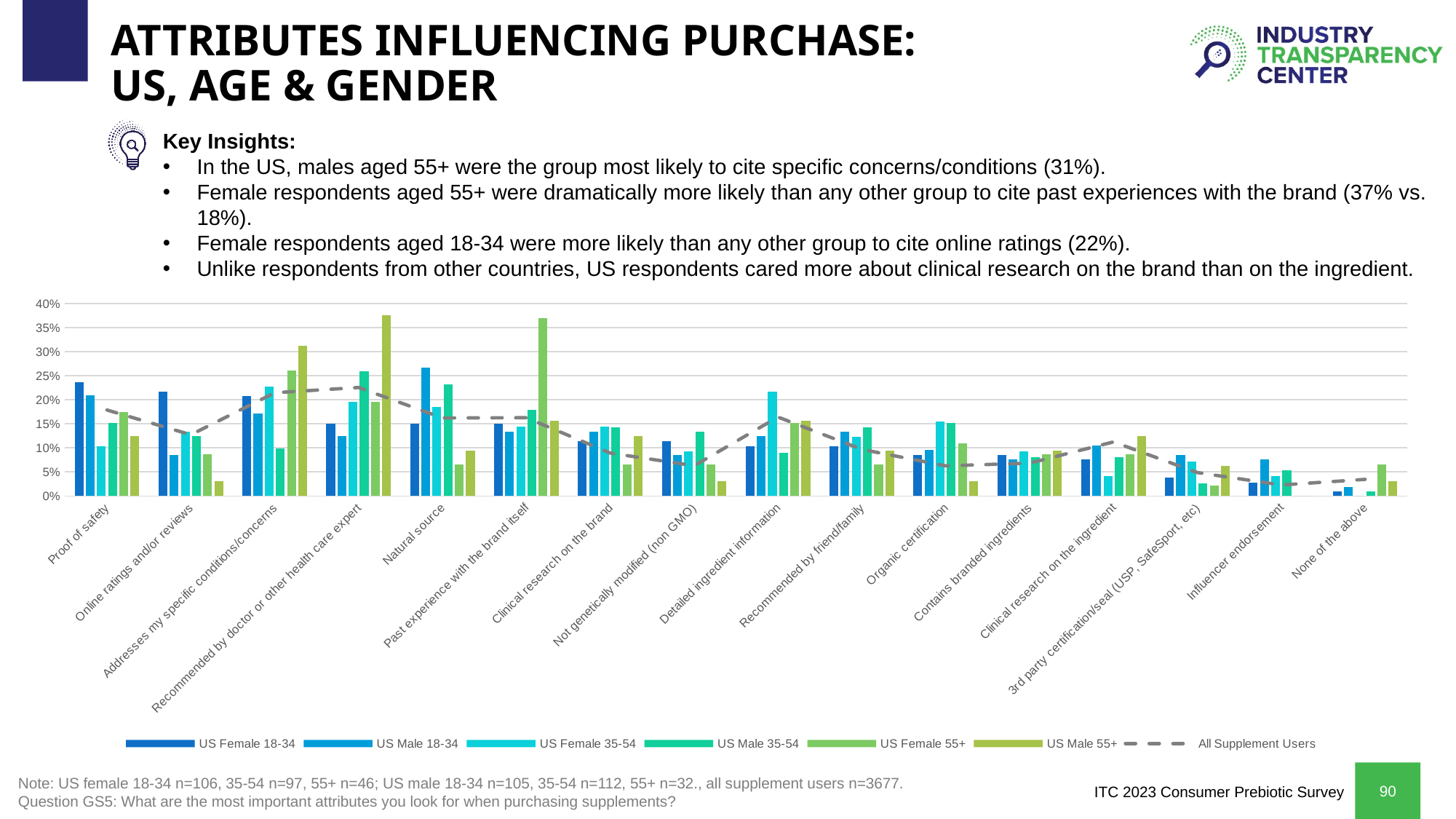
Which series is shown in dark blue in the chart legend? US Female 18-34 How many attribute categories are shown along the x axis of the chart? 16 Is the value for US Female 55+ on 'Past experience with the brand itself' greater or less than 35%? greater Is the value for US Male 55+ on 'Addresses my specific conditions/concerns' greater or less than 25%? greater What does the dashed grey line in the chart represent? All Supplement Users Which series has the highest bar for 'Recommended by doctor or other health care expert'? US Male 55+ How many series does the chart legend list? 7 For 'Proof of safety', which is larger: the value for US Female 18-34 or US Male 55+? US Female 18-34 Is the value for US Female 18-34 on 'None of the above' greater or less than 5%? less For 'Past experience with the brand itself', which is larger: the value for US Female 55+ or US Male 55+? US Female 55+ What kind of chart is shown on the slide? combination bar and line chart Which series has the lowest bar for 'Online ratings and/or reviews'? US Male 55+